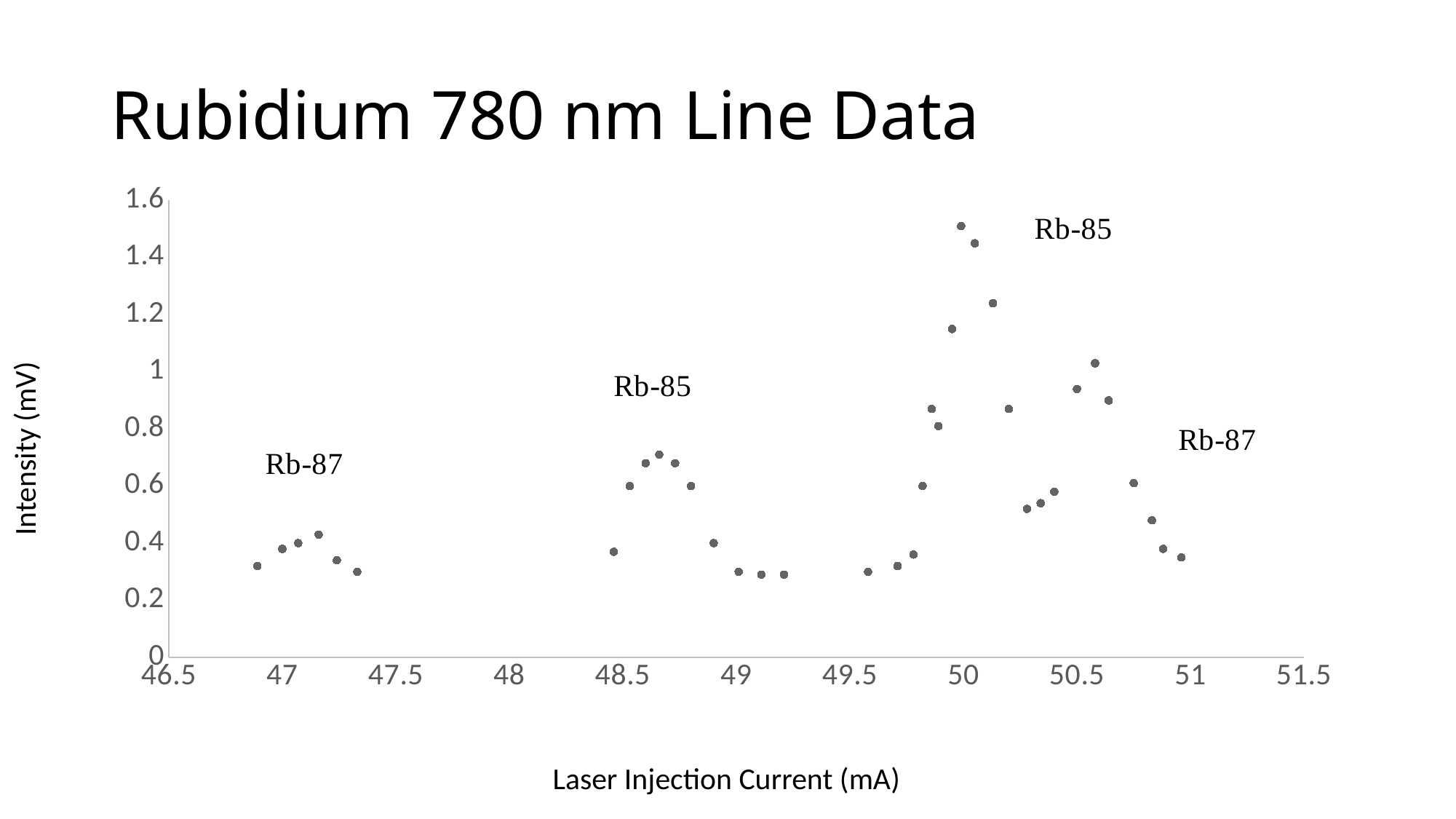
Which labelled peak has the lowest intensity? Rb-87 (near 47 mA) Is the peak intensity of the Rb-87 feature near 47.2 mA greater or less than 0.6? less Is the peak intensity of the Rb-87 feature near 50.6 mA greater or less than 1.2? less How many labelled peaks are marked on the chart? 4 Is the peak intensity of the Rb-85 feature near 48.7 mA greater or less than 0.6? greater Which labelled peak has the highest intensity? Rb-85 (near 50 mA) What is the label of the y axis? Intensity (mV) What kind of chart is shown on the slide? Scatter plot Is the peak near 48.7 mA higher or lower in intensity than the peak near 47.2 mA? higher Between about 48.7 mA and 49.2 mA, do the intensity values rise or fall as current increases? fall What is the title of the chart? Rubidium 780 nm Line Data